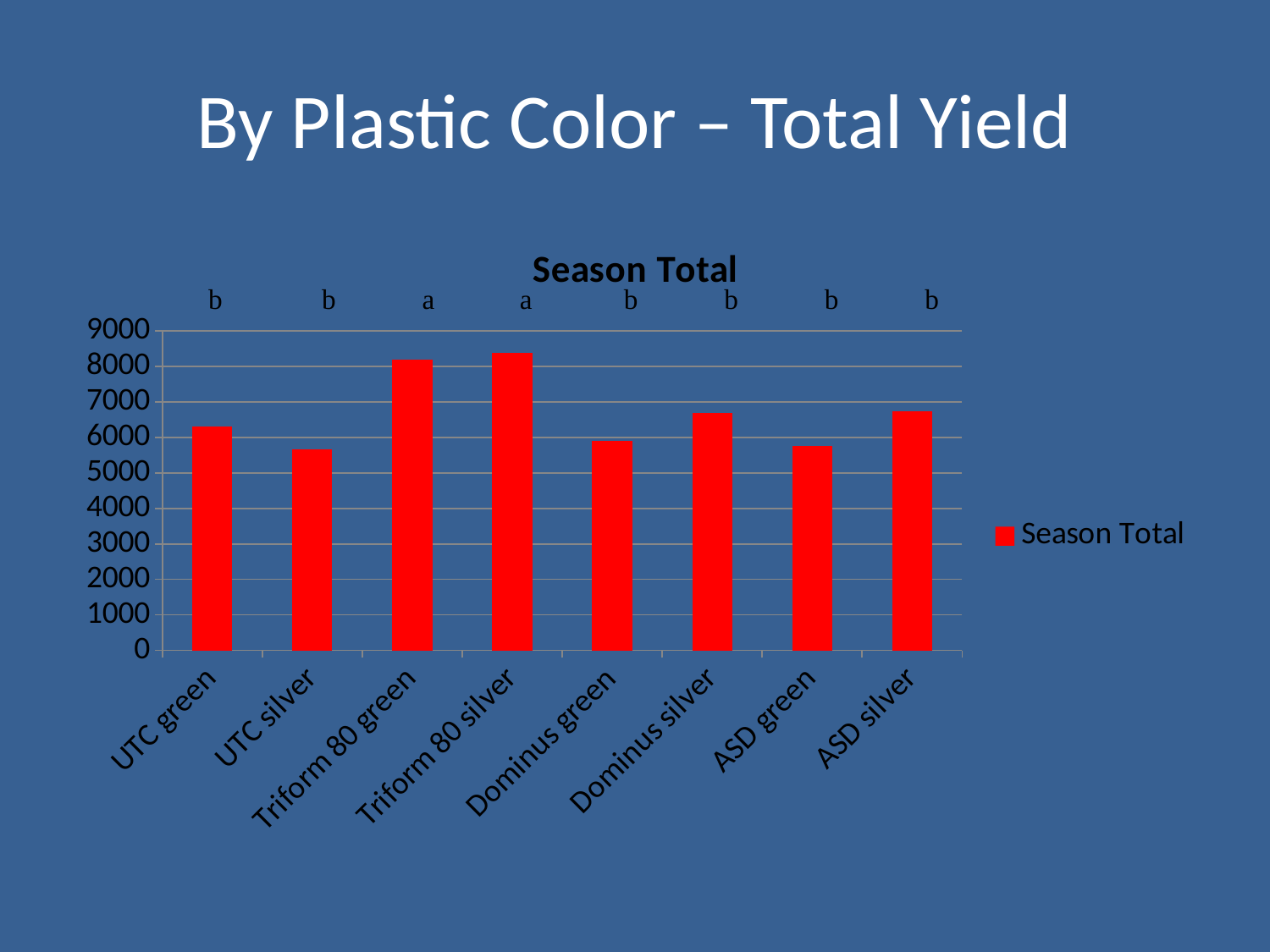
What colour are the bars in the chart? red What kind of chart is shown on the slide? bar chart How many series does the legend list? 1 Is the value for UTC green greater or less than 6000? greater Is the value for ASD green greater or less than 6000? less What is the title of the chart? Season Total Is the value for Dominus silver greater or less than 6000? greater Which has the larger value, Dominus silver or Dominus green? Dominus silver How many categories are plotted on the x axis of the chart? 8 Which has the larger value, Triform 80 green or UTC green? Triform 80 green